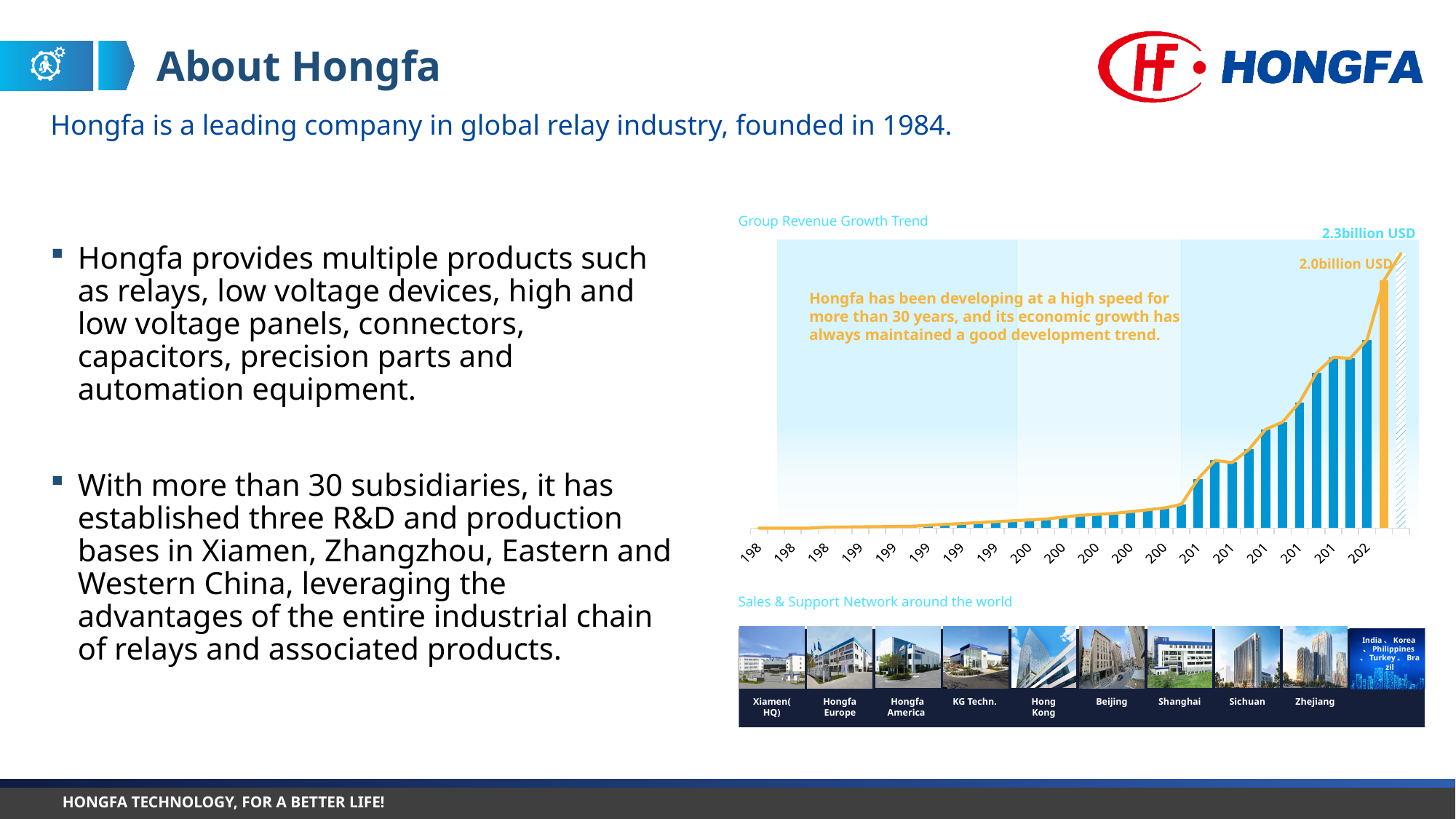
In the Group Revenue Growth Trend chart, what is the highest revenue value labelled on the chart? 2.3billion USD In the Group Revenue Growth Trend chart, what is the difference between the two labelled values, 2.3billion USD and 2.0billion USD? 0.3billion USD In the Group Revenue Growth Trend chart, what value is labelled on the hatched bar at the far right? 2.3billion USD What kind of chart is the Group Revenue Growth Trend chart? Bar chart with a line In the Group Revenue Growth Trend chart, what value is labelled on the orange bar? 2.0billion USD In the Group Revenue Growth Trend chart, do the revenue values rise or fall along the x axis? Rise In the Group Revenue Growth Trend chart, which is larger: the value of the orange bar or the value of the hatched bar at the far right? The hatched bar at the far right What colour are most of the bars in the Group Revenue Growth Trend chart? Blue In the Group Revenue Growth Trend chart, where along the x axis is the lowest revenue bar located? At the far left What is the title of the chart on the slide? Group Revenue Growth Trend